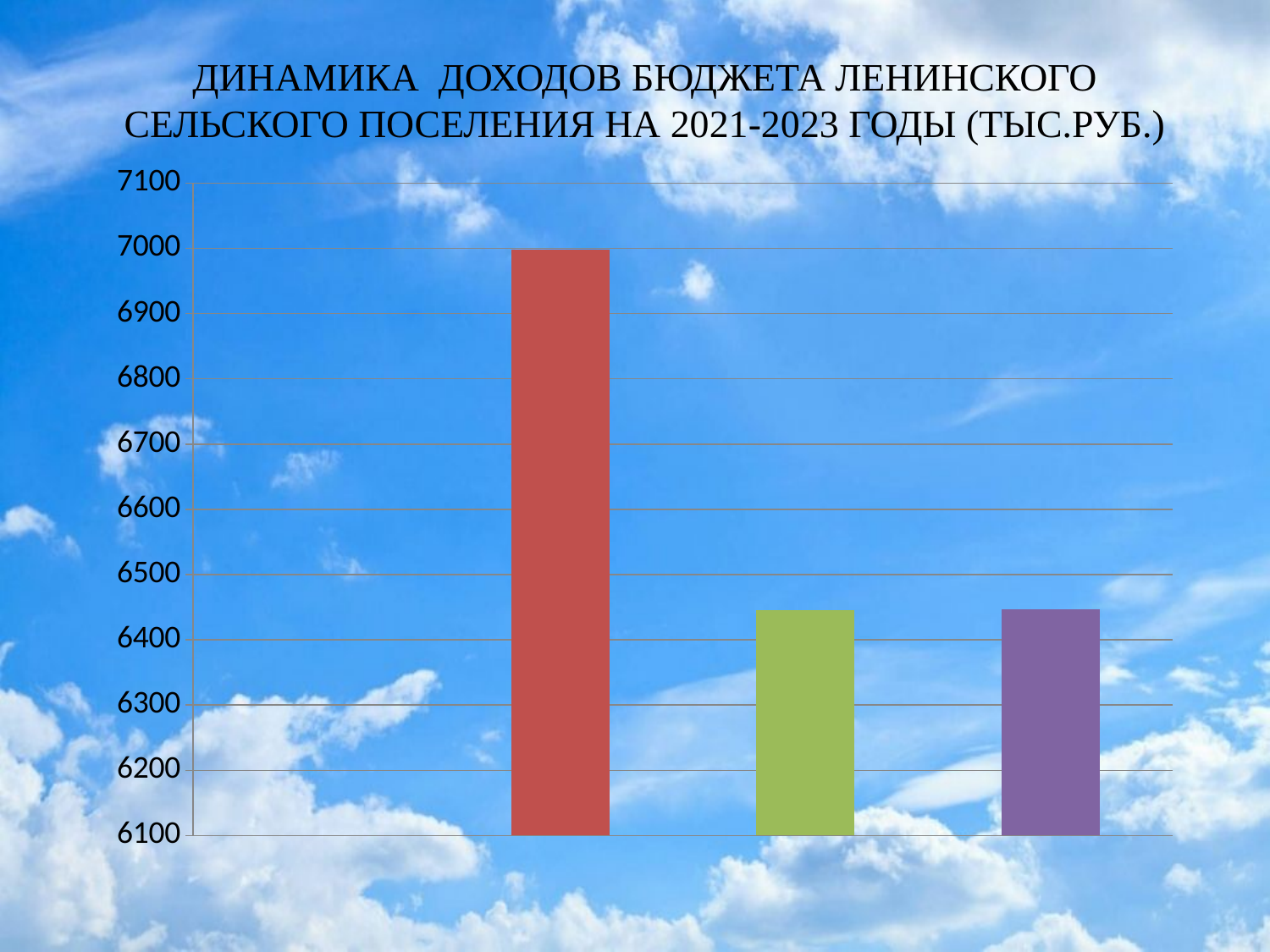
Which bar is the highest in the chart? the red (first) bar Is the value of the green (middle) bar greater or less than 6400? greater Is the value of the green (middle) bar greater or less than 6500? less Is the value of the purple (last) bar greater or less than 6500? less What is the highest value shown on the vertical axis? 7100 What is the lowest value shown on the vertical axis? 6100 What kind of chart is shown on the slide? bar chart How many bars are plotted in the chart? 3 Which is larger, the red (first) bar or the purple (last) bar? the red (first) bar